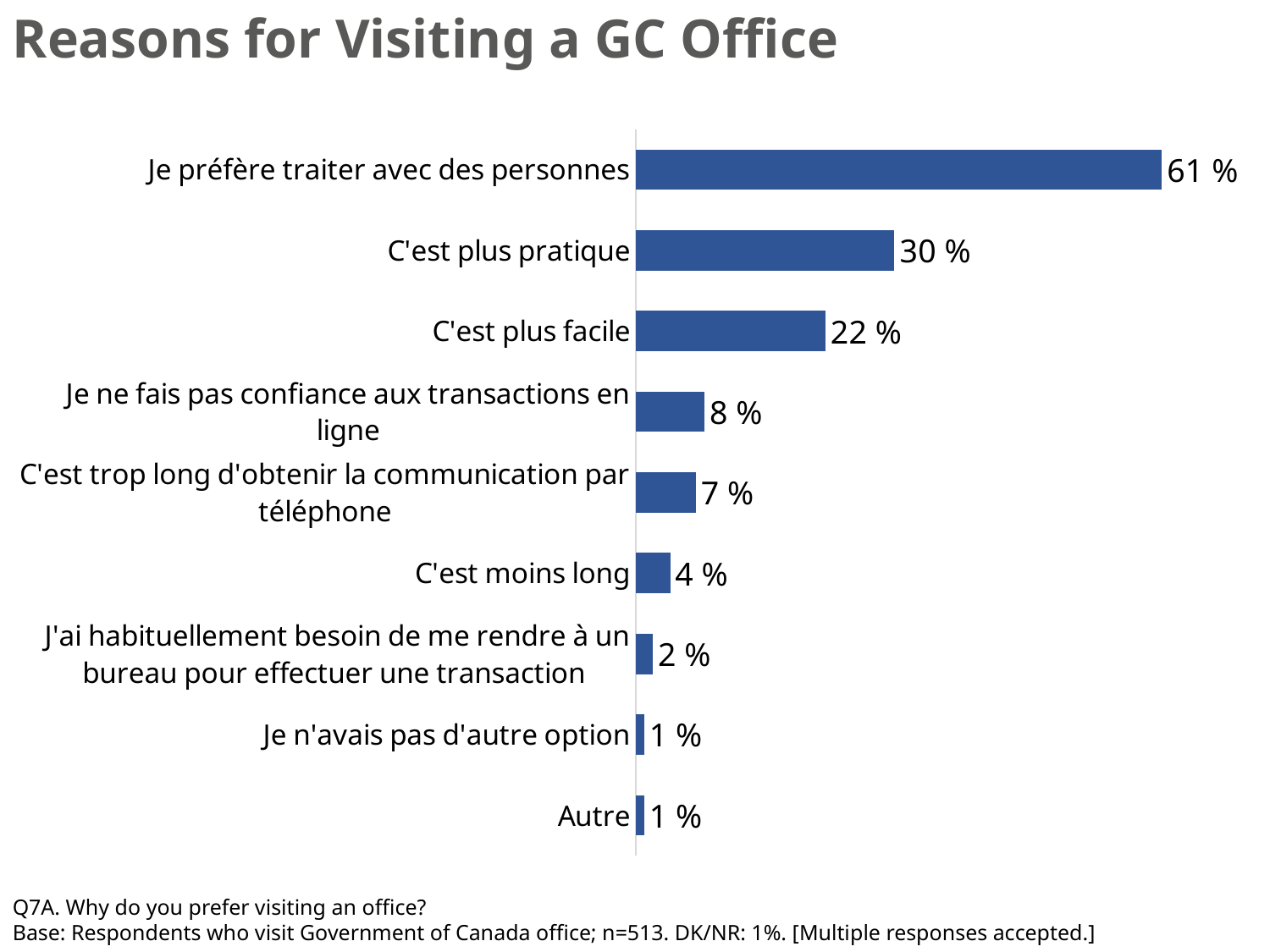
What is the difference between "C'est plus pratique" and "C'est plus facile"? 8 % What is the value for "Je préfère traiter avec des personnes"? 61 % Which category has the highest value? Je préfère traiter avec des personnes Which is larger, "Je ne fais pas confiance aux transactions en ligne" or "C'est trop long d'obtenir la communication par téléphone"? Je ne fais pas confiance aux transactions en ligne What is the value for "C'est moins long"? 4 % What is the value for "Je ne fais pas confiance aux transactions en ligne"? 8 % What kind of chart is shown on the slide? Bar chart What is the value for "C'est plus pratique"? 30 % What is the difference between "Je préfère traiter avec des personnes" and "C'est plus pratique"? 31 % How many categories are shown in the chart? 9 What is the title of the chart? Reasons for Visiting a GC Office What is the value for "C'est plus facile"? 22 %